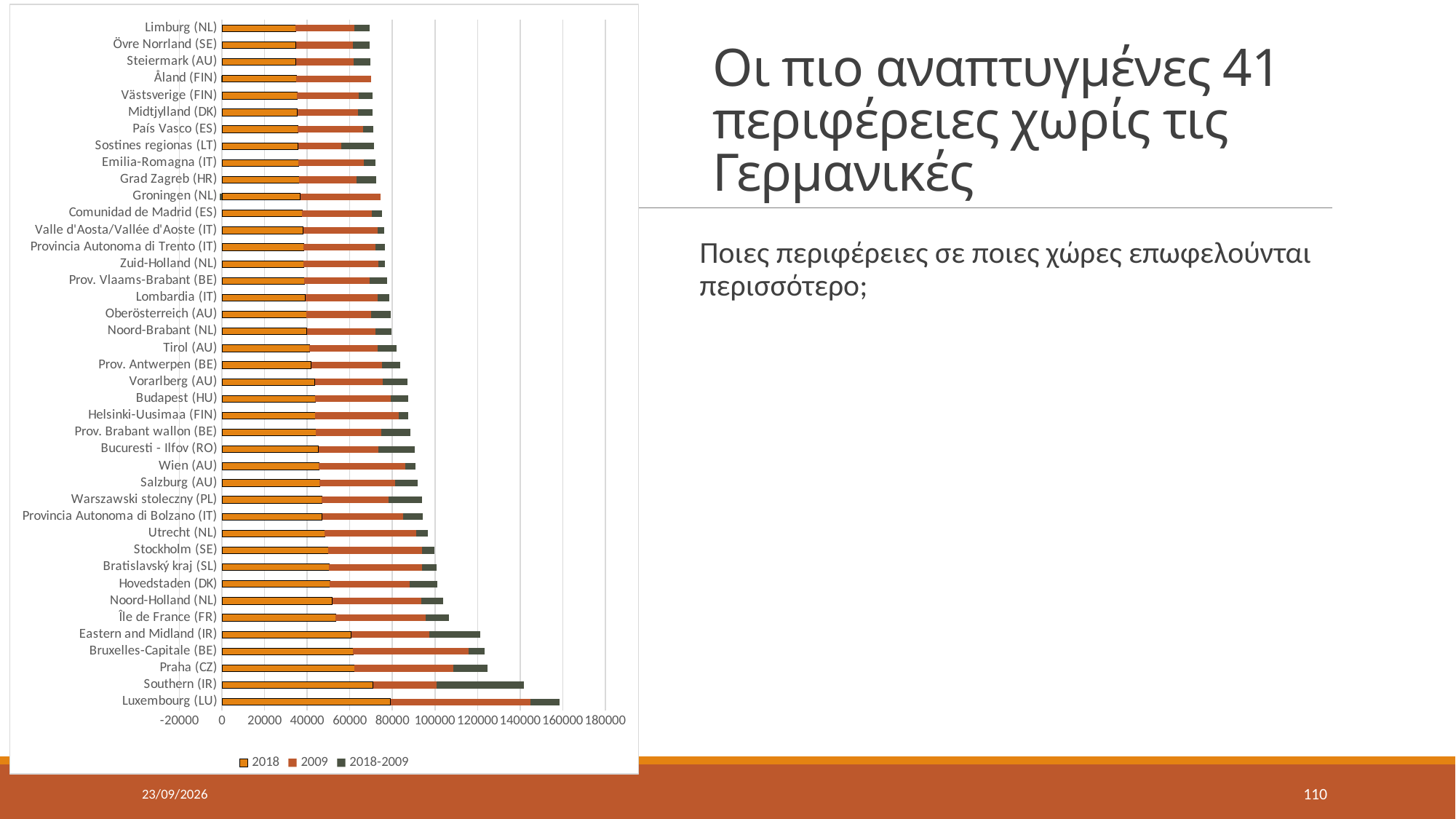
Is the total bar for Eastern and Midland (IR) greater or less than 100000? greater How many series does the legend list? 3 Which has the longer total bar, Praha (CZ) or Utrecht (NL)? Praha (CZ) Is the total bar for Limburg (NL) greater or less than 80000? less What is the highest value shown on the horizontal axis? 180000 What are the series names listed in the legend? 2018, 2009, 2018-2009 Is the 2018 segment for Île de France (FR) greater or less than 40000? greater Which region has the longest total bar? Luxembourg (LU) Do the total bar lengths increase or decrease going from the bottom of the chart to the top? decrease How many regions are plotted on the chart? 41 What kind of chart is shown on the slide? bar chart